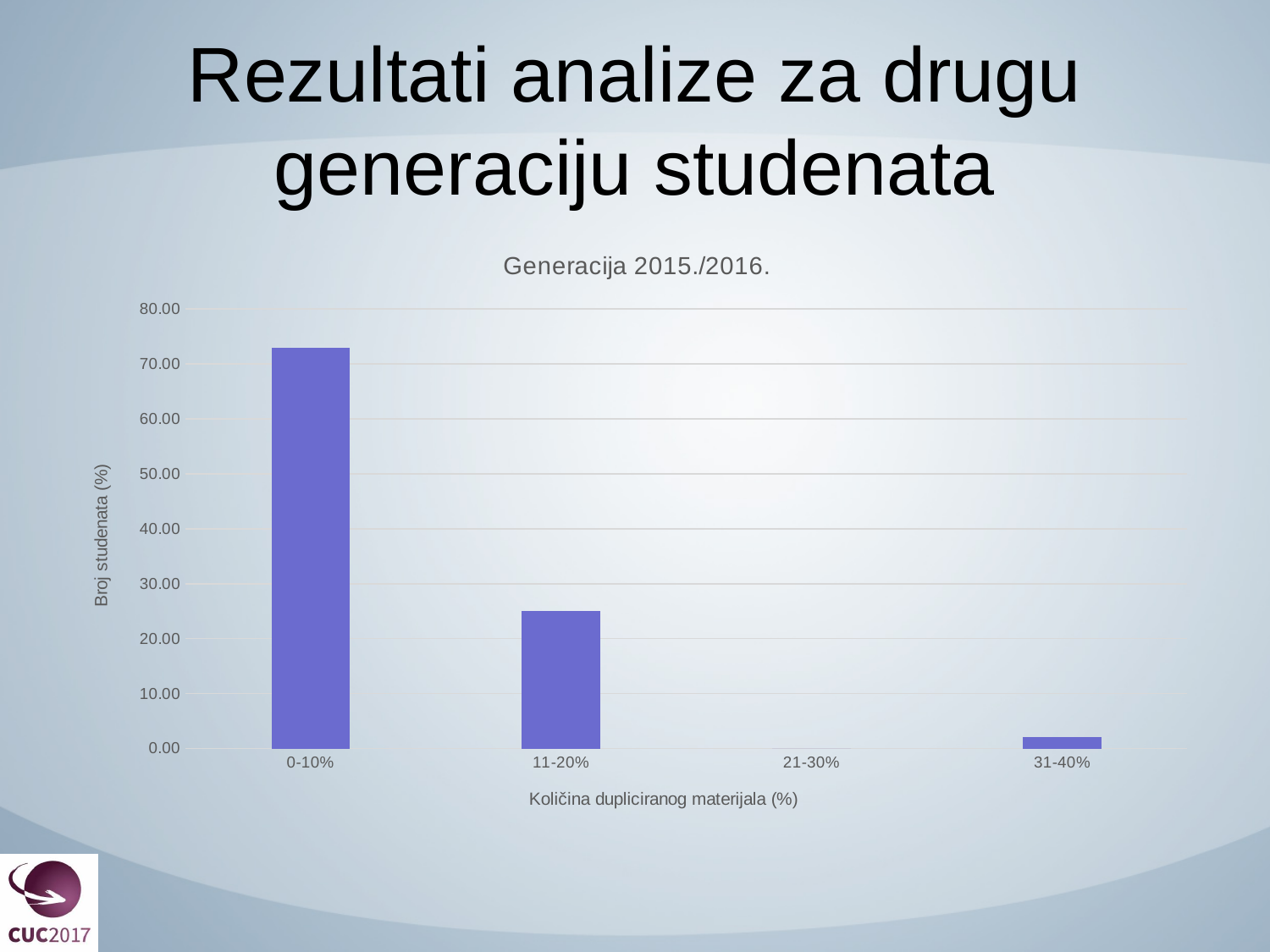
Is the value for 11-20% greater or less than 30.00? less How many categories are shown on the x axis of the chart? 4 What is the title of the chart? Generacija 2015./2016. Which is larger, the value for 0-10% or the value for 11-20%? 0-10% Which is larger, the value for 11-20% or the value for 31-40%? 11-20% Is the value for 0-10% greater or less than 70.00? greater Which category has the lowest value in the chart? 21-30% Is the value for 31-40% greater or less than 10.00? less What is the label of the y axis of the chart? Broj studenata (%) What kind of chart is shown on the slide? bar chart Which category has the highest value in the chart? 0-10%